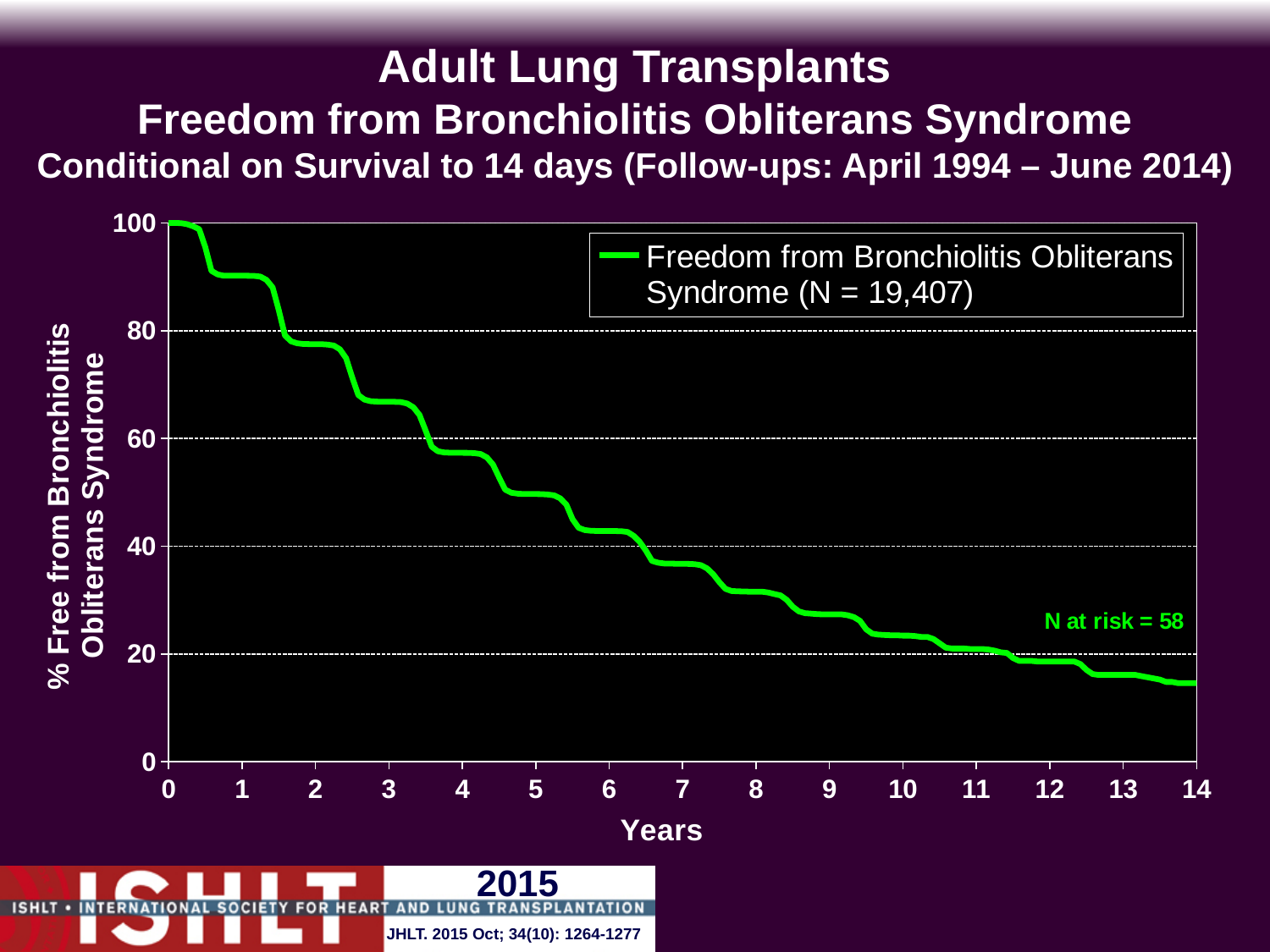
How many series does the legend list? 1 What is the value of the curve at year 0? 100 Does the percentage free from Bronchiolitis Obliterans Syndrome rise or fall as years increase? fall Is the value at year 2 larger or smaller than the value at year 9? larger Is the value at year 7 greater or less than 40? less What is the N at risk shown at the end of the curve? 58 Is the value at year 14 greater or less than 20? less Is the value at year 1 greater or less than 80? greater What is the N given in the legend for the Freedom from Bronchiolitis Obliterans Syndrome series? 19,407 What kind of chart is shown on the slide? line chart